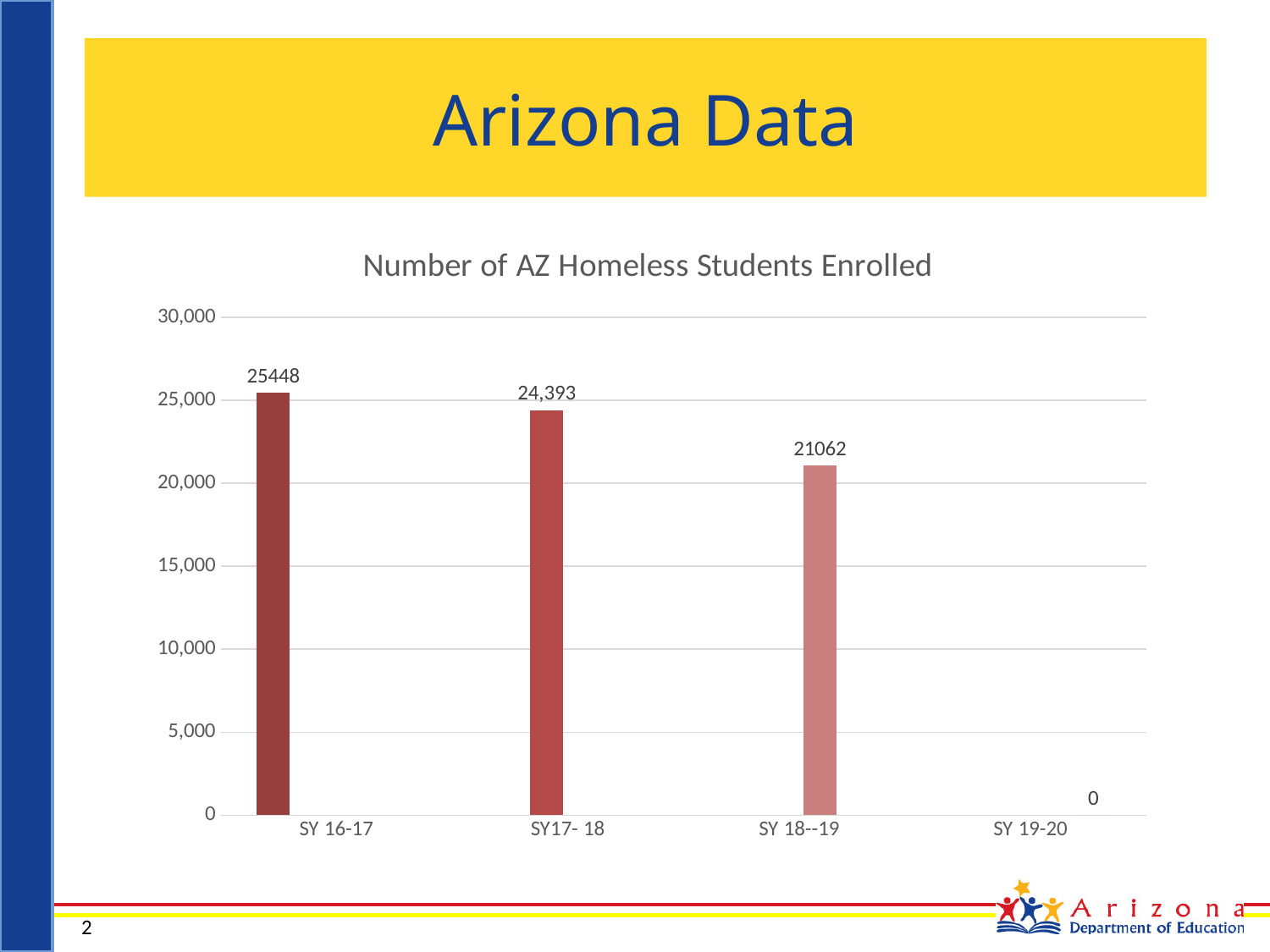
What is the value for SY 18--19 in the Number of AZ Homeless Students Enrolled chart? 21062 What is the difference between the values for SY17- 18 and SY 18--19? 3331 Which school year has the highest number of AZ homeless students enrolled? SY 16-17 What is the value for SY 16-17 in the Number of AZ Homeless Students Enrolled chart? 25448 What is the value for SY17- 18 in the Number of AZ Homeless Students Enrolled chart? 24,393 Do the values rise or fall from SY 16-17 to SY 18--19? Fall What kind of chart is shown on the slide? Bar chart Which school year has the lowest value in the chart? SY 19-20 What value is shown for SY 19-20 in the chart? 0 What is the difference between the values for SY 16-17 and SY 18--19? 4386 Which is larger, the value for SY 16-17 or the value for SY17- 18? SY 16-17 How many school-year categories are shown on the x axis of the chart? 4